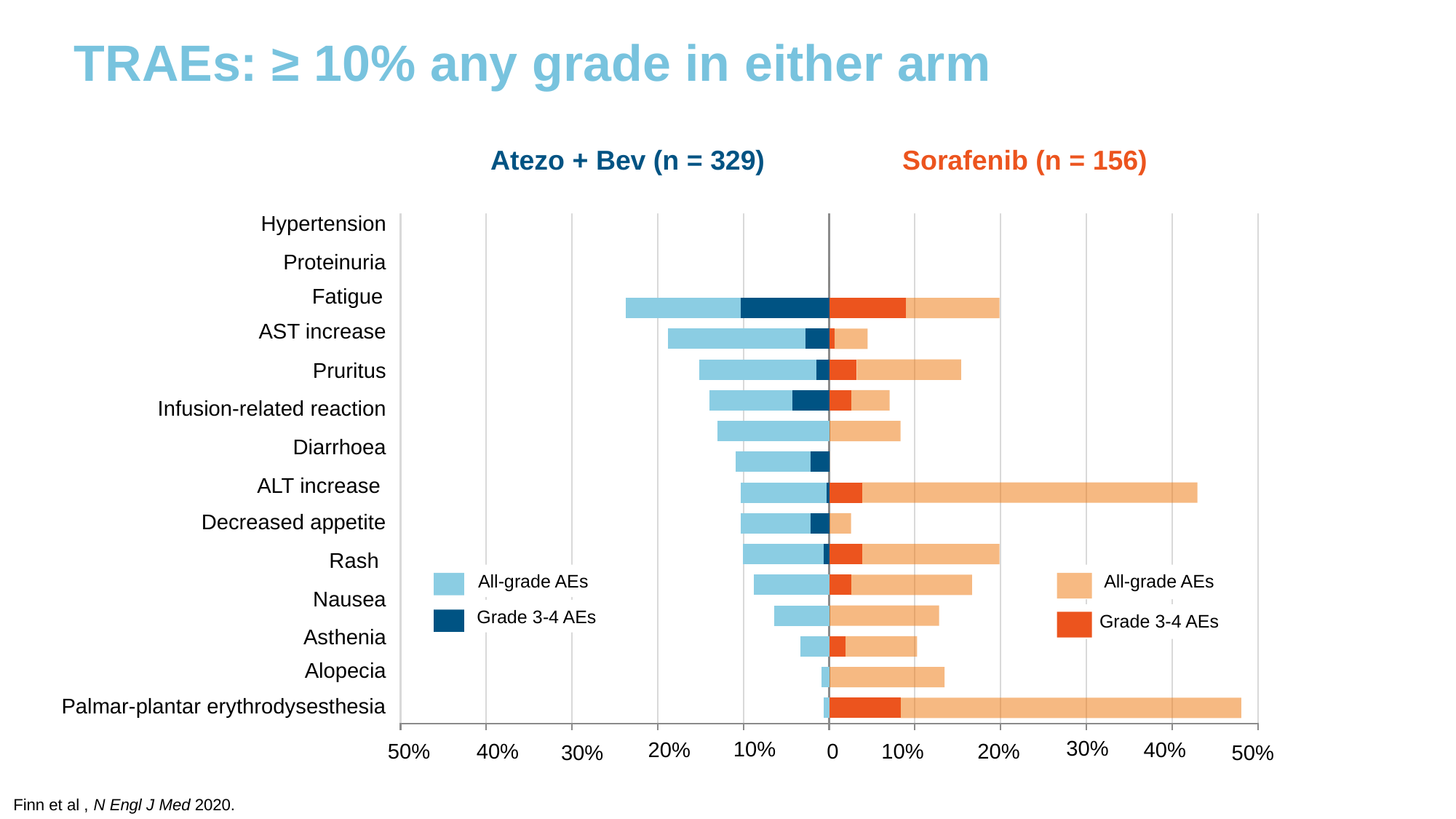
What are the two legend entries shown for the Sorafenib arm? All-grade AEs and Grade 3-4 AEs For Fatigue, which arm has the larger all-grade value, Atezo + Bev or Sorafenib? Atezo + Bev Is the all-grade value for Alopecia in the Atezo + Bev arm greater or less than 10%? less Is the all-grade value for Fatigue in the Atezo + Bev arm greater or less than 20%? greater What kind of chart is shown on the slide? bar chart How many series does the legend list for the Atezo + Bev arm? 2 Is the all-grade value for Palmar-plantar erythrodysesthesia in the Sorafenib arm greater or less than 40%? greater For Palmar-plantar erythrodysesthesia, which arm has the larger all-grade value, Atezo + Bev or Sorafenib? Sorafenib What is the sample size shown for the Sorafenib arm? n = 156 Which adverse event has the longest all-grade bar in the Sorafenib arm? Palmar-plantar erythrodysesthesia How many adverse event categories are listed on the vertical axis? 14 Which adverse event has the longest all-grade bar in the Atezo + Bev arm? Fatigue